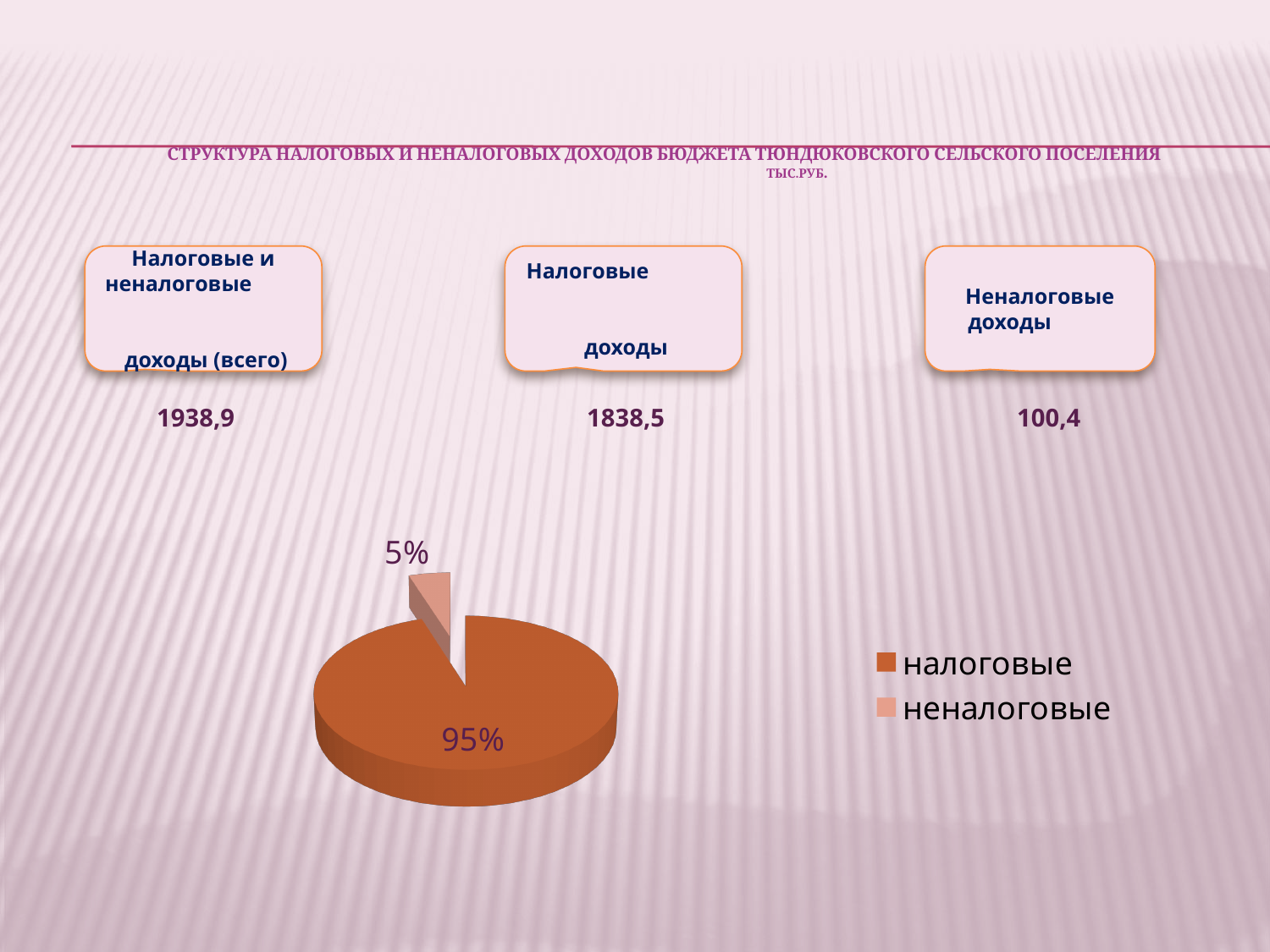
What colour is the налоговые slice in the pie chart? dark orange-brown How many slices does the pie chart have? 2 Which slice of the pie chart is the smallest? неналоговые What is the difference in percentage points between the налоговые and неналоговые slices? 90 How many entries does the legend of the pie chart list? 2 What share of the pie does the неналоговые slice represent? 5% What share of the pie does the налоговые slice represent? 95% Which slice of the pie chart is the largest? налоговые What kind of chart is shown on the slide? pie chart Which legend entry is shown in light pink? неналоговые Which is larger in the pie chart, налоговые or неналоговые? налоговые